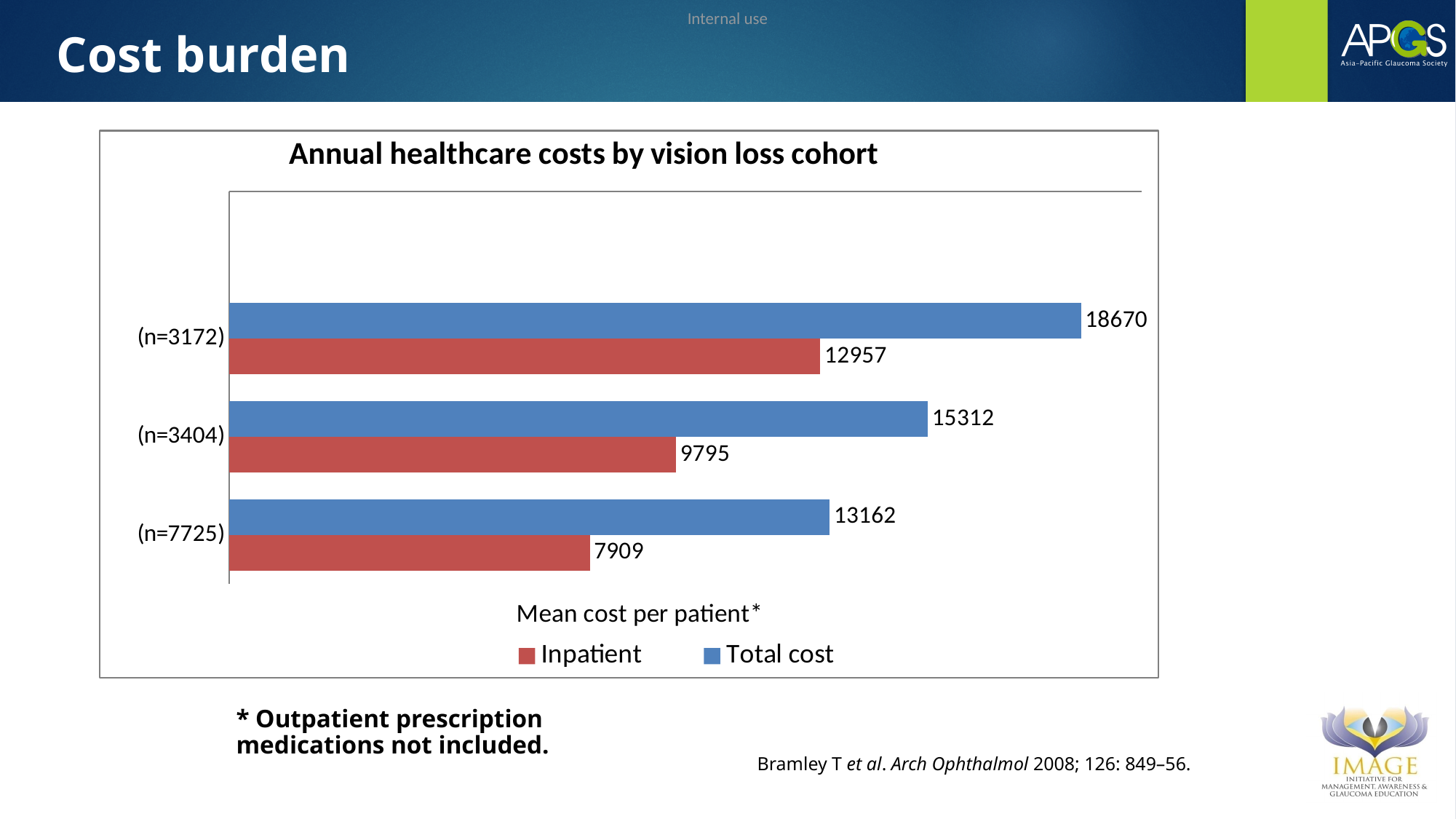
Which cohort has the highest Total cost? (n=3172) What is the Total cost value for the (n=3172) cohort? 18670 How many cohorts are shown on the chart? 3 What is the difference in Total cost between the (n=3172) and (n=7725) cohorts? 5508 What is the Inpatient value for the (n=3404) cohort? 9795 What is the difference between Total cost and Inpatient cost for the (n=3404) cohort? 5517 What kind of chart is shown? Bar chart Which is larger: the Inpatient cost for (n=3172) or the Total cost for (n=7725)? Total cost for (n=7725) Which cohort has the lowest Inpatient cost? (n=7725) How many series does the legend list? 2 What is the Inpatient value for the (n=7725) cohort? 7909 What is the title of the chart? Annual healthcare costs by vision loss cohort